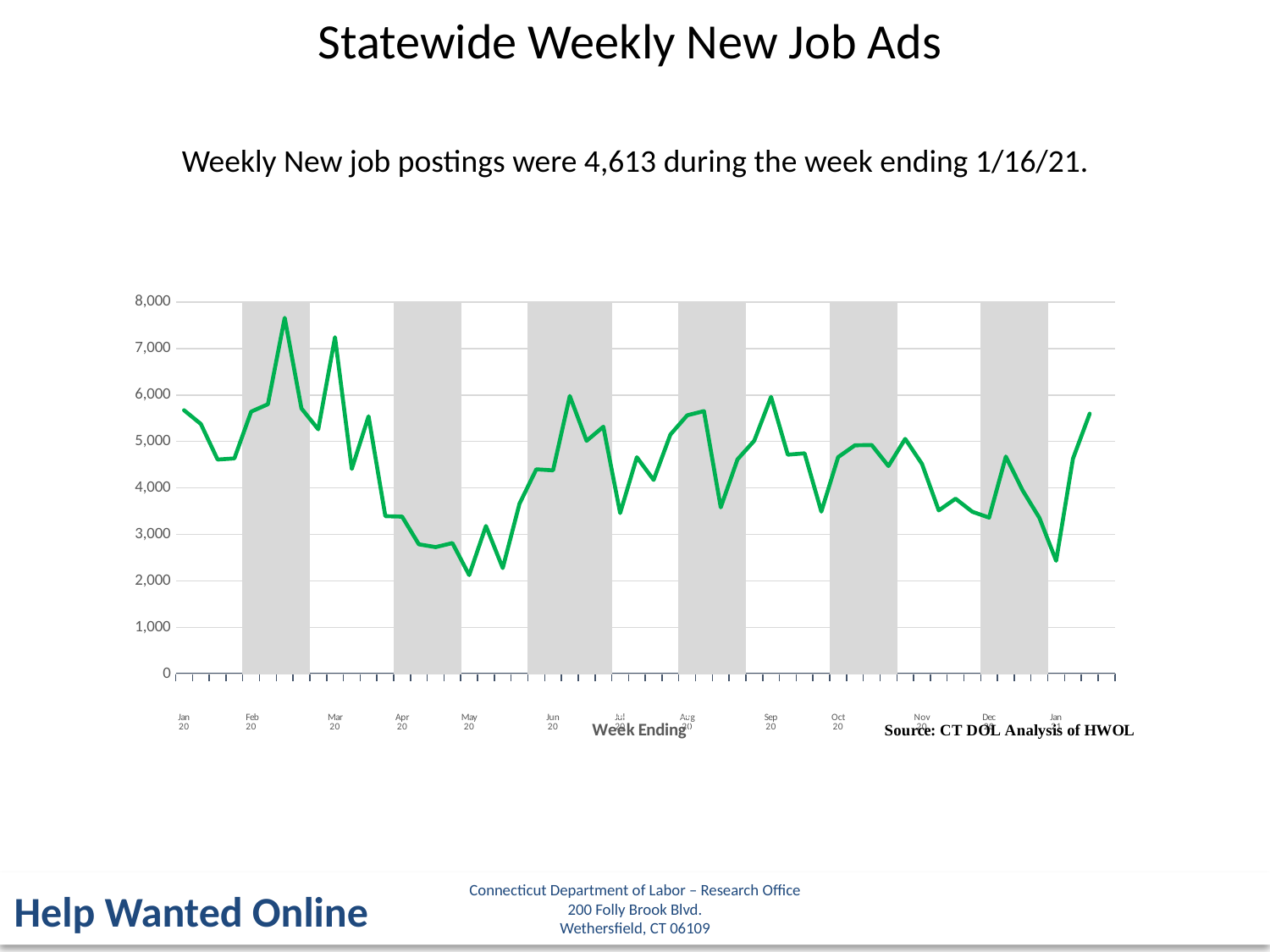
Is the first plotted value, at Jan 20, greater or less than 5,000? greater How many data series (lines) are plotted on the chart? 1 What kind of chart is shown on the slide? line chart What is the label on the x axis of the chart? Week Ending In which month does the line reach its highest point? Feb 20 Is the dip in the line at the start of Oct 20 greater or less than 4,000? less In which month does the line reach its lowest point? May 20 Which is larger: the value at the start of Jan 20 or the lowest value in May 20? Jan 20 Is the highest value on the chart, in Feb 20, greater or less than 7,000? greater Do the values generally rise or fall between the Feb 20 peak and May 20? fall What is the title of the chart on the slide? Statewide Weekly New Job Ads